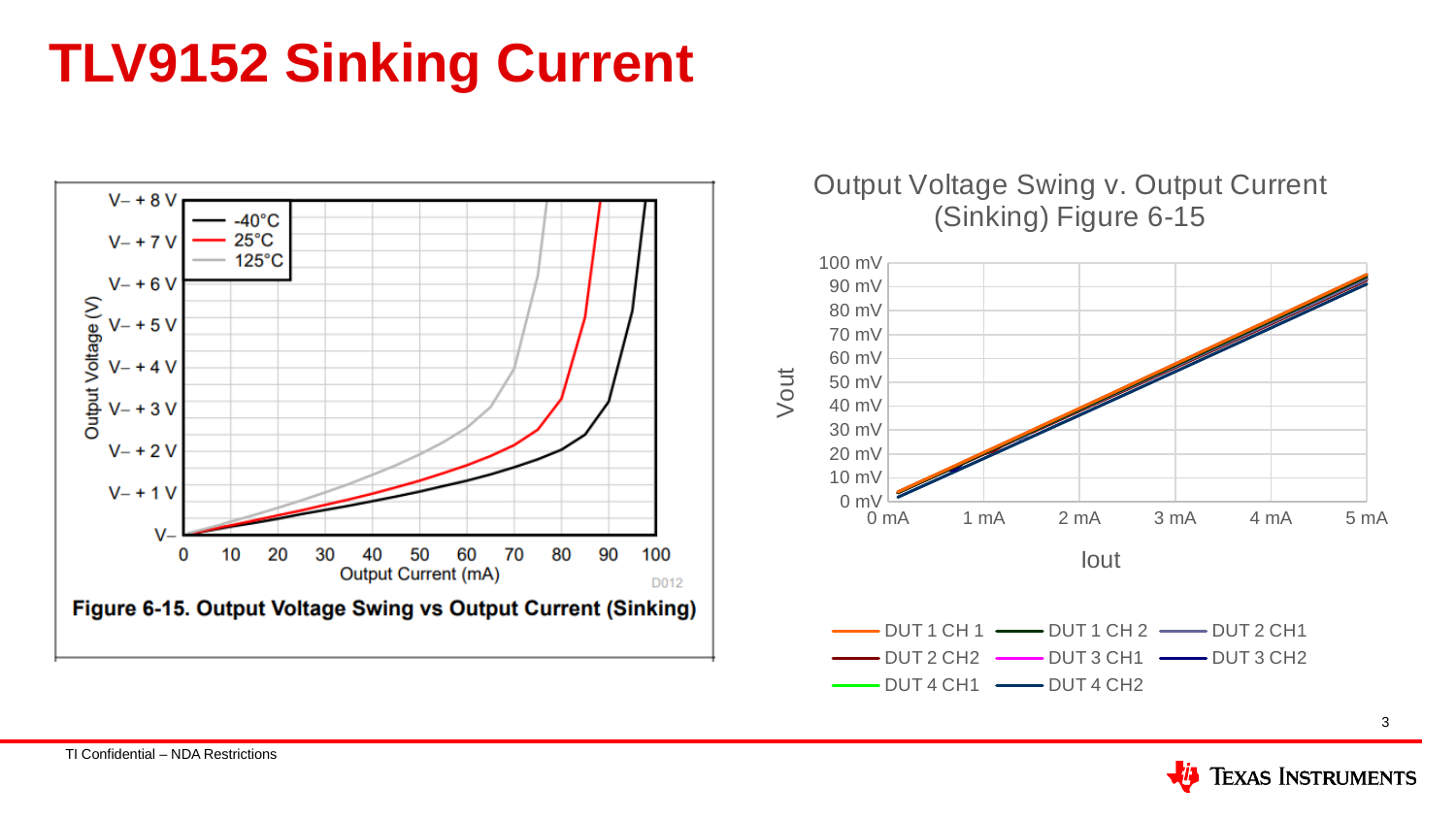
In the right-hand chart (Output Voltage Swing v. Output Current (Sinking) Figure 6-15), is the value for DUT 1 CH 1 at 1 mA greater or less than 30 mV? less What kind of chart is the left-hand chart, Figure 6-15 Output Voltage Swing vs Output Current (Sinking)? line chart What is the y-axis title of the right-hand chart (Output Voltage Swing v. Output Current (Sinking) Figure 6-15)? Vout In the right-hand chart (Output Voltage Swing v. Output Current (Sinking) Figure 6-15), is the value for DUT 4 CH2 at 3 mA greater or less than 40 mV? greater In the right-hand chart (Output Voltage Swing v. Output Current (Sinking) Figure 6-15), is the value for DUT 1 CH 1 at 5 mA greater or less than 80 mV? greater How many series does the legend of the left-hand chart (Figure 6-15 Output Voltage Swing vs Output Current (Sinking)) list? 3 What is the x-axis title of the right-hand chart (Output Voltage Swing v. Output Current (Sinking) Figure 6-15)? Iout What kind of chart is the right-hand chart titled "Output Voltage Swing v. Output Current (Sinking) Figure 6-15"? line chart How many series does the legend of the right-hand chart (Output Voltage Swing v. Output Current (Sinking) Figure 6-15) list? 8 In the right-hand chart (Output Voltage Swing v. Output Current (Sinking) Figure 6-15), do the Vout values rise or fall as Iout increases? rise In the left-hand chart (Figure 6-15 Output Voltage Swing vs Output Current (Sinking)), does the output voltage rise or fall as output current increases? rise